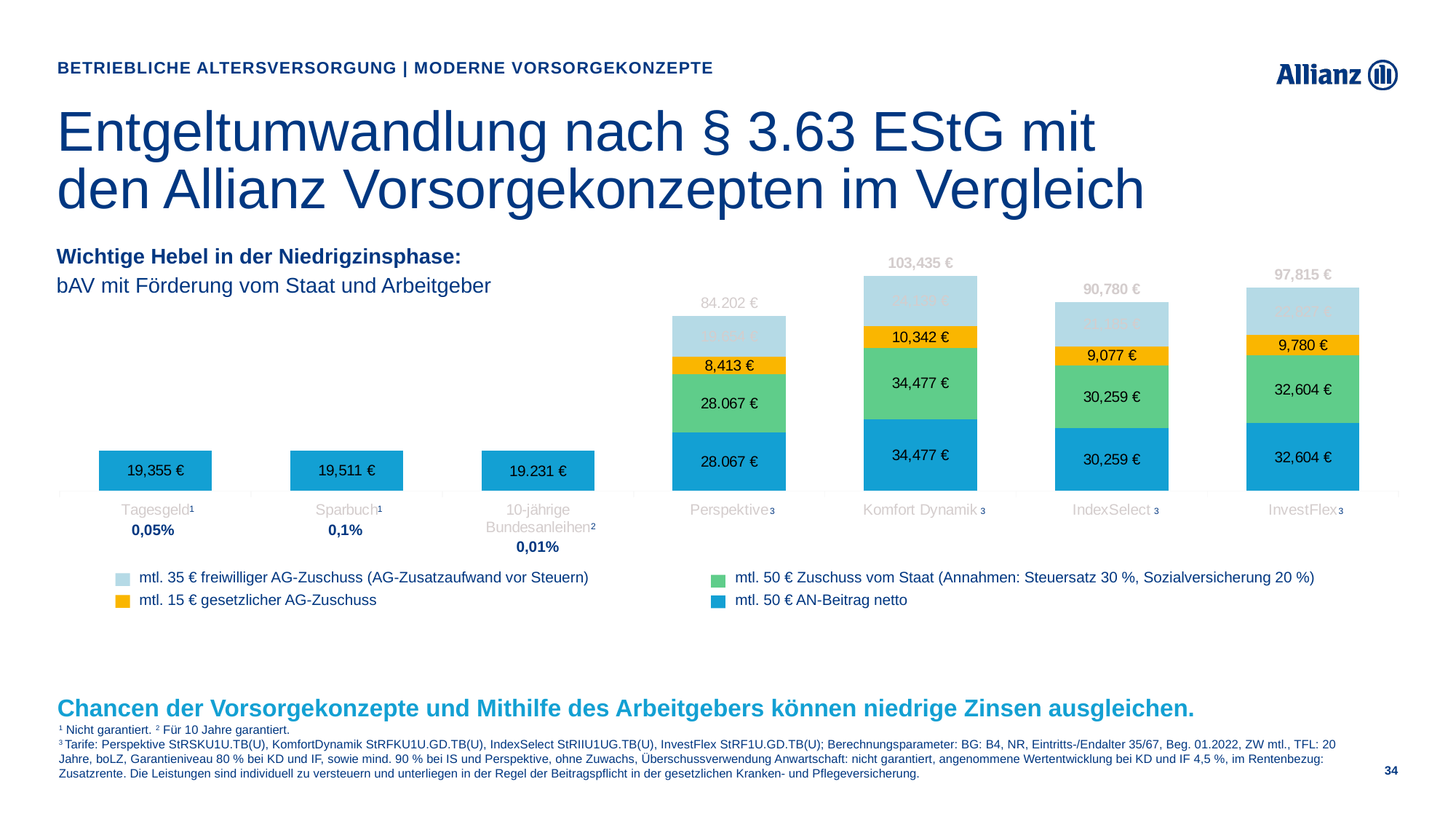
How many series does the chart legend list? 4 What is the value of the 'mtl. 15 € gesetzlicher AG-Zuschuss' segment for InvestFlex? 9,780 € What interest rate is shown below the Sparbuch category? 0,1% What kind of chart is shown on the slide? Stacked bar chart What is the total value shown above the Komfort Dynamik bar? 103,435 € Which category has the highest total value? Komfort Dynamik Which has the larger total, Perspektive or IndexSelect? IndexSelect Which category has the lowest value? 10-jährige Bundesanleihen What is the value of the 'mtl. 50 € Zuschuss vom Staat' segment for IndexSelect? 30,259 € What is the difference between the total for Komfort Dynamik and the total for InvestFlex? 5,620 € What is the value shown for Tagesgeld? 19,355 € How many categories are shown along the x axis of the chart? 7